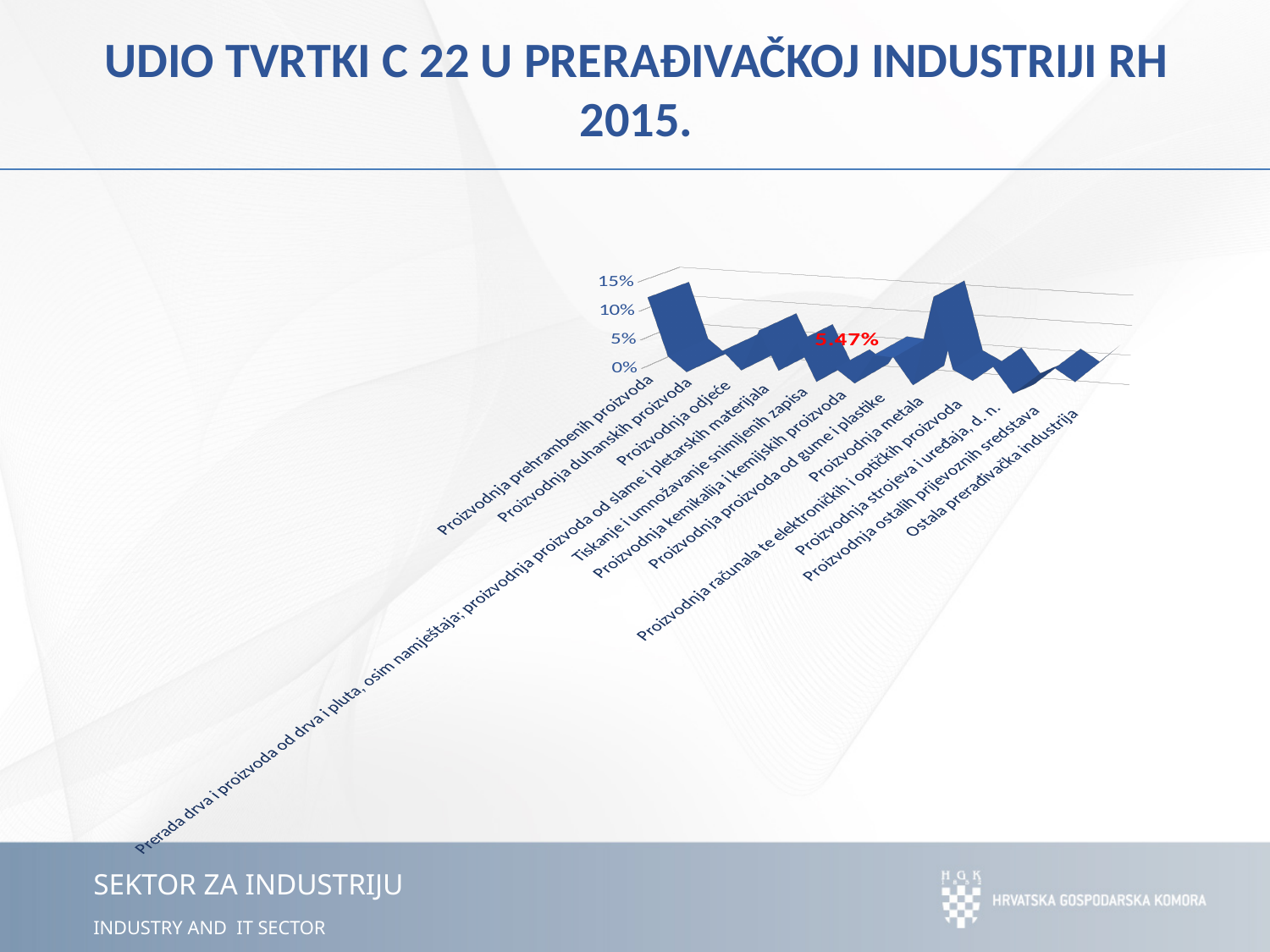
Is the value for Proizvodnja proizvoda od gume i plastike greater or less than 5%? greater Is the value for Ostala prerađivačka industrija greater or less than 5%? less Is the value for Proizvodnja prehrambenih proizvoda greater or less than 10%? greater What is the highest value shown on the chart's vertical axis? 15% What kind of chart is shown on the slide? 3D line chart What is the title of the slide containing the chart? UDIO TVRTKI C 22 U PRERAĐIVAČKOJ INDUSTRIJI RH 2015. What value is labelled on the chart for Proizvodnja proizvoda od gume i plastike? 5.47%